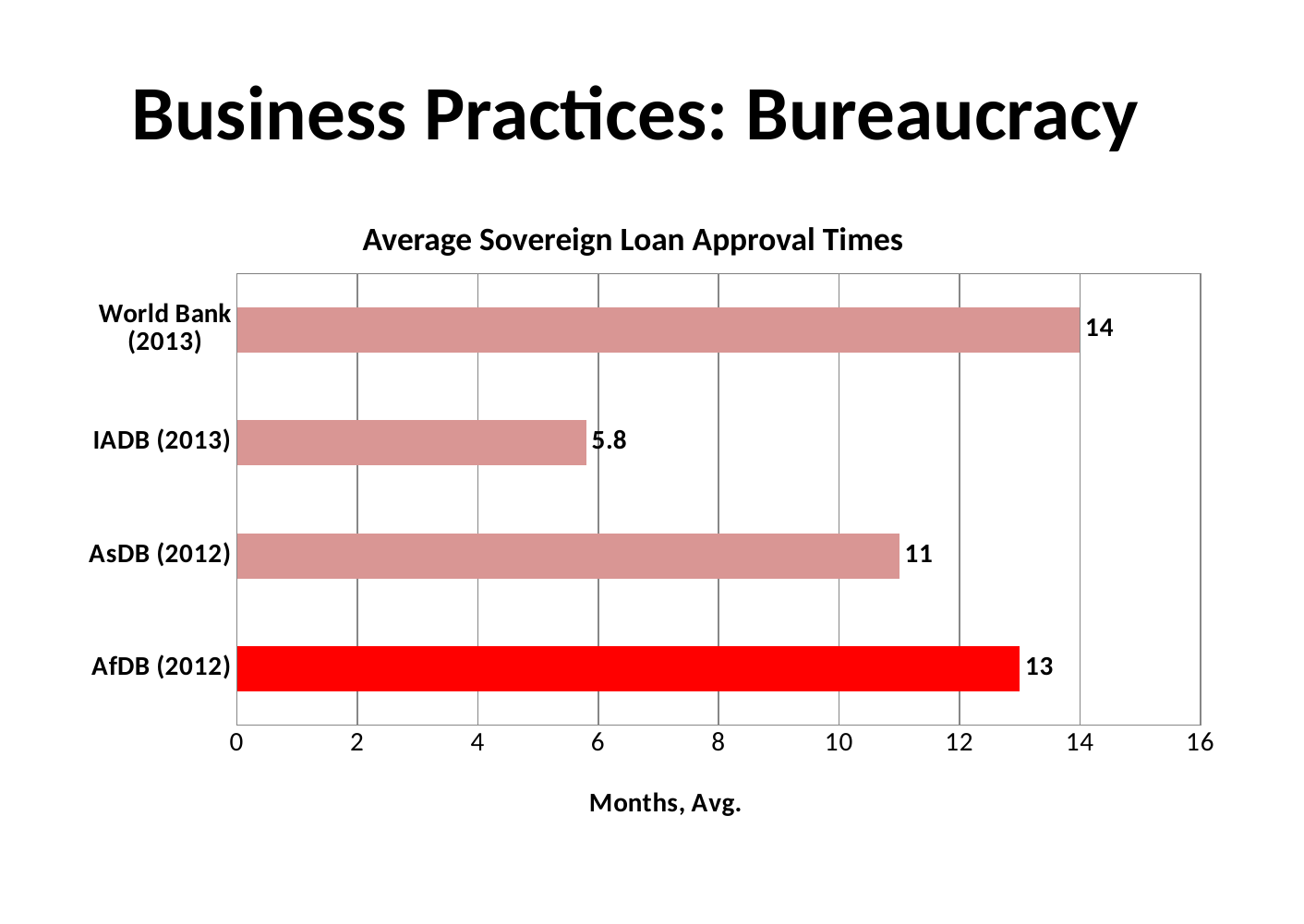
Is the value for IADB (2013) greater or less than 6? less Which institution has the lowest average loan approval time? IADB (2013) Which institution has the highest average loan approval time? World Bank (2013) What is the average sovereign loan approval time for World Bank (2013)? 14 What kind of chart is shown on the slide? bar chart How many institutions are shown in the chart? 4 What is the title of the chart? Average Sovereign Loan Approval Times Which is larger, the value for AsDB (2012) or AfDB (2012)? AfDB (2012) What is the value shown for IADB (2013)? 5.8 What is the difference between the World Bank (2013) and AfDB (2012) values? 1 What is the difference between the AsDB (2012) and IADB (2013) values? 5.2 What is the value shown for AfDB (2012)? 13